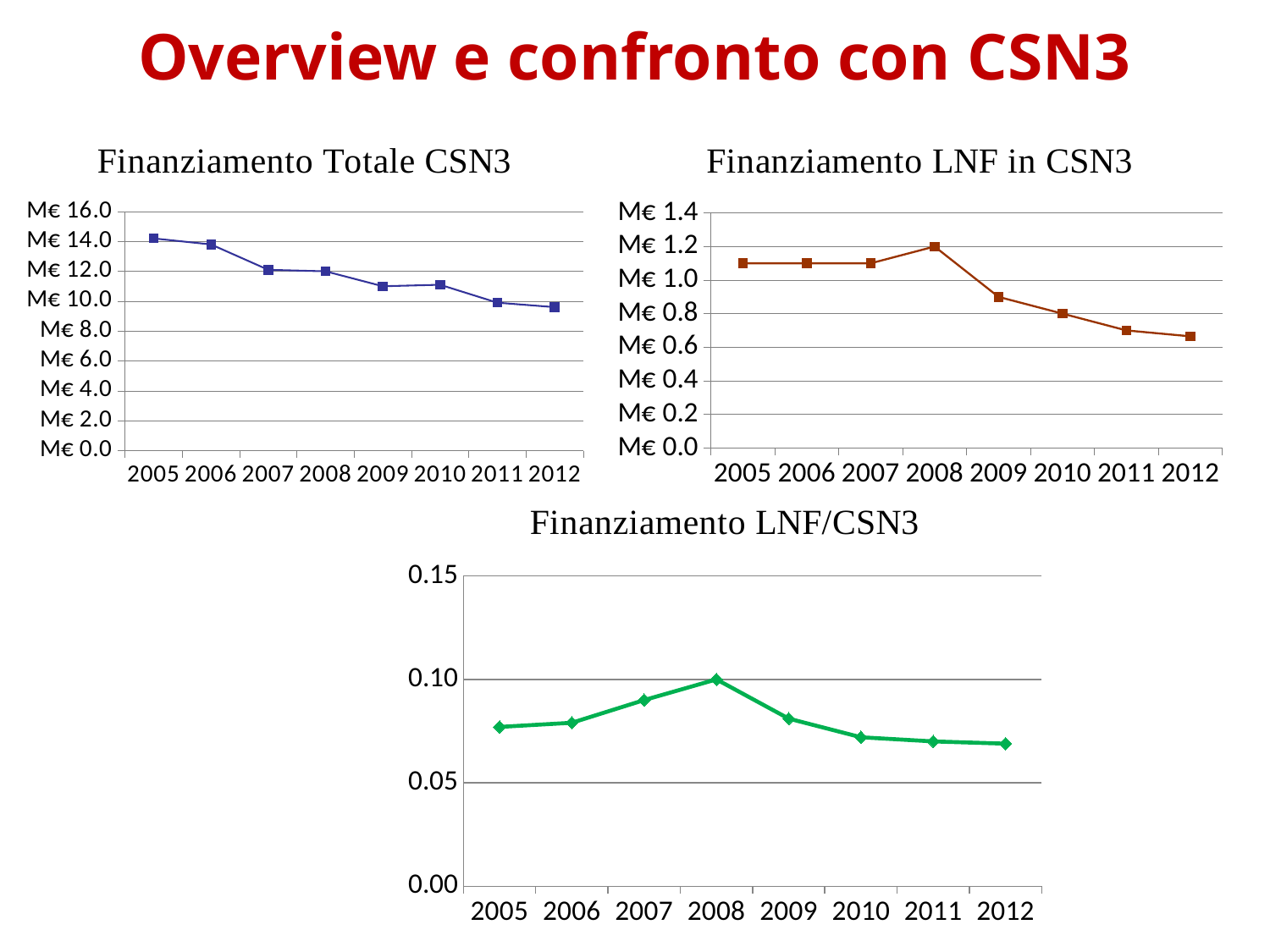
In the "Finanziamento Totale CSN3" chart, how many years are plotted on the x axis? 8 What kind of chart is "Finanziamento Totale CSN3"? line chart In the "Finanziamento LNF/CSN3" chart, which is larger, the value for 2008 or the value for 2012? 2008 In the "Finanziamento Totale CSN3" chart, which year has the highest value? 2005 In the "Finanziamento Totale CSN3" chart, do the values generally rise or fall from 2005 to 2012? fall In the "Finanziamento LNF in CSN3" chart, which year has the highest value? 2008 In the "Finanziamento LNF/CSN3" chart, what is the value for 2008? 0.10 In the "Finanziamento Totale CSN3" chart, is the value for 2012 greater or less than M€ 10.0? less In the "Finanziamento LNF in CSN3" chart, what is the value for 2008? M€ 1.2 In the "Finanziamento Totale CSN3" chart, is the value for 2009 greater or less than M€ 10.0? greater In the "Finanziamento LNF in CSN3" chart, is the value for 2012 greater or less than M€ 0.8? less How many charts are on the slide? 3